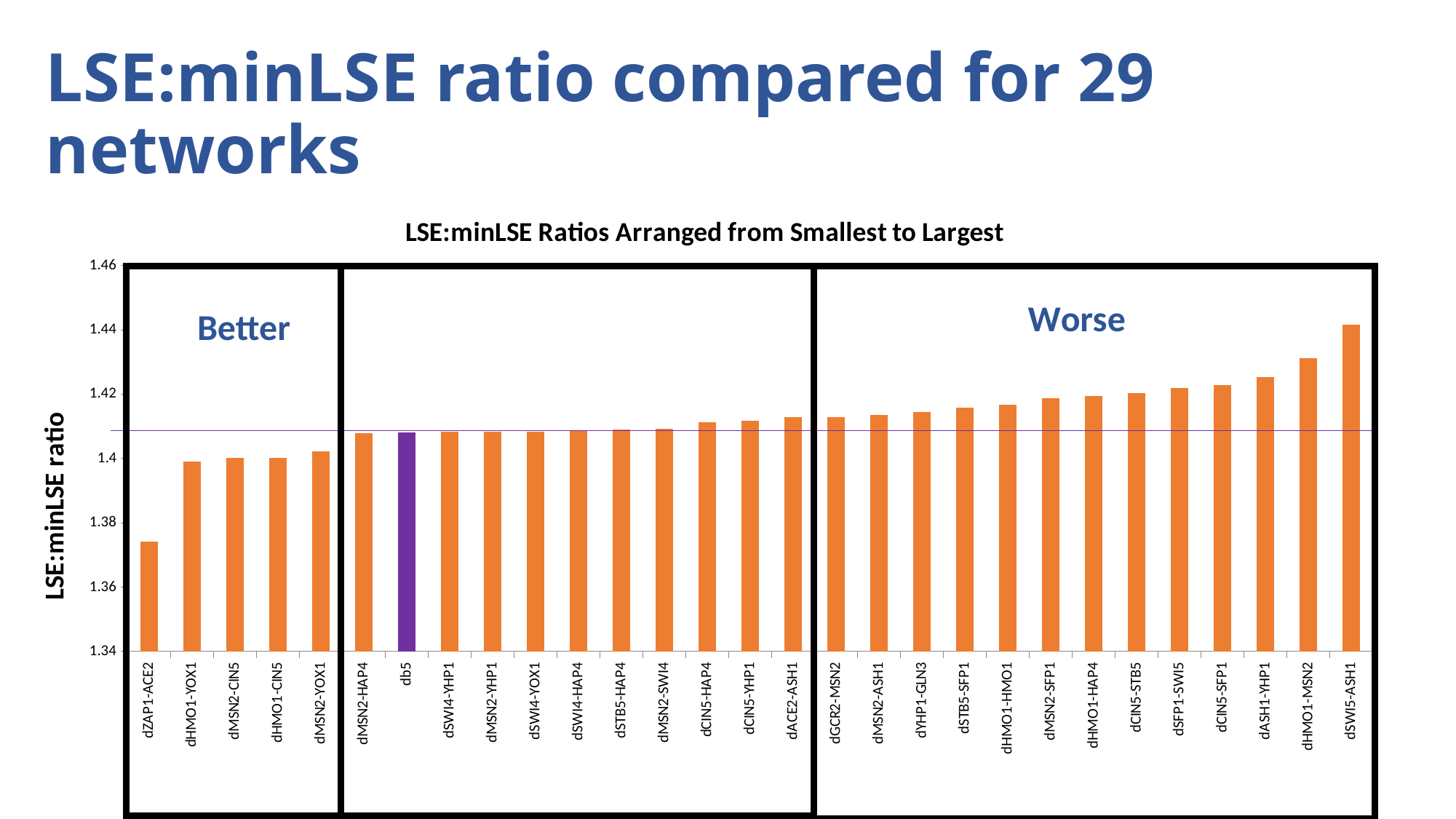
Which network's bar is coloured purple instead of orange? db5 Is the LSE:minLSE ratio for dHMO1-MSN2 greater or less than 1.42? greater What kind of chart is shown on the slide? bar chart Is the LSE:minLSE ratio for dZAP1-ACE2 greater or less than 1.38? less Is the LSE:minLSE ratio for dACE2-ASH1 greater or less than 1.40? greater What is the title of the chart? LSE:minLSE Ratios Arranged from Smallest to Largest Which has a larger LSE:minLSE ratio, dHMO1-MSN2 or db5? dHMO1-MSN2 Do the LSE:minLSE ratios rise or fall from left to right along the x axis? rise How many networks (bars) are plotted in the chart? 29 Which network has the lowest LSE:minLSE ratio? dZAP1-ACE2 Which network has the highest LSE:minLSE ratio? dSWI5-ASH1